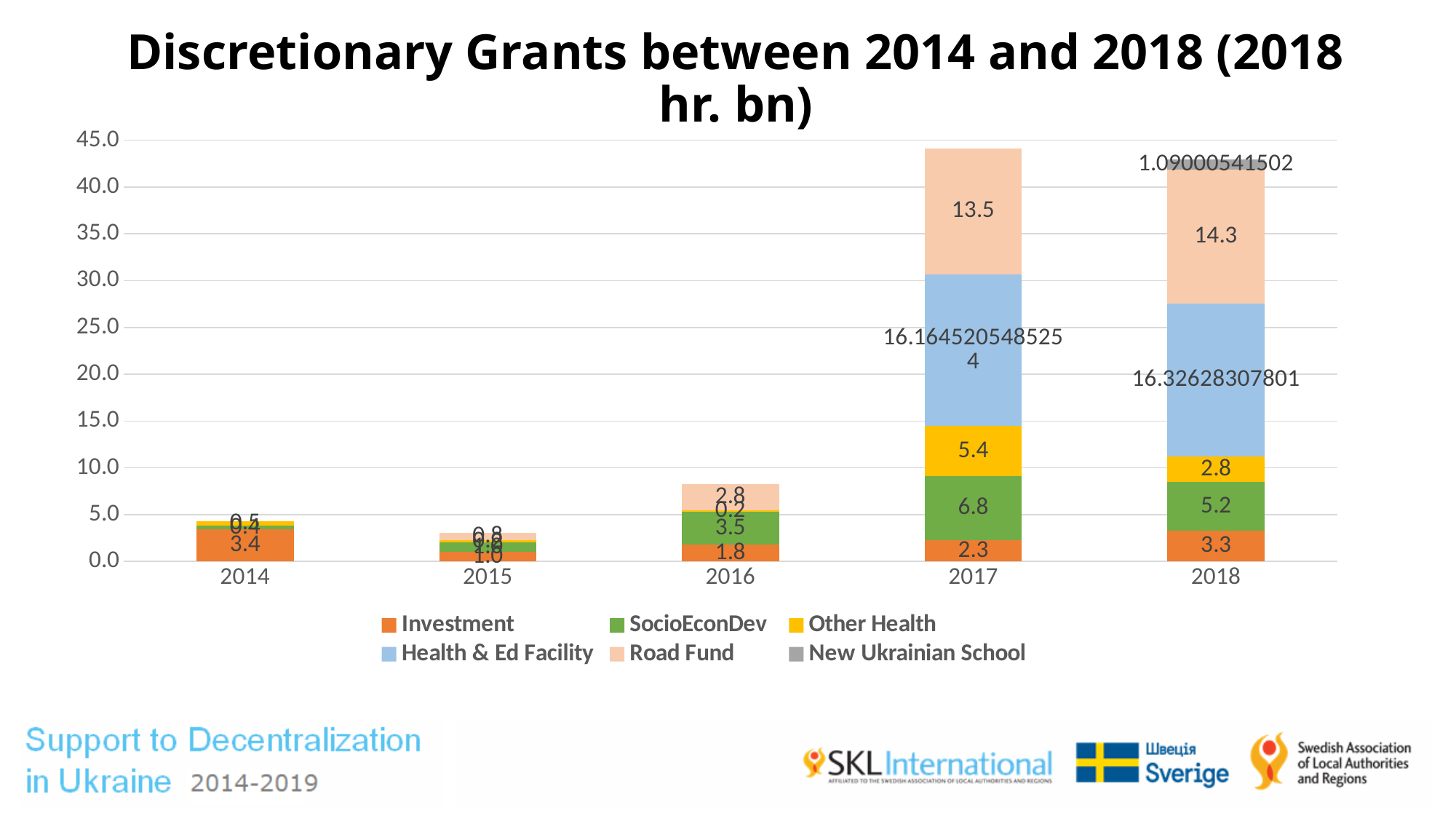
What is the Investment value for 2016? 1.8 What is the Investment value for 2018? 3.3 Which year has a larger Road Fund value, 2017 or 2018? 2018 What kind of chart is shown on the slide? Stacked bar chart What is the SocioEconDev value for 2017? 6.8 Which year has the tallest stacked bar overall? 2017 How many series does the legend list? 6 What is the Road Fund value for 2017? 13.5 How many years are shown on the x axis? 5 Is the total stacked bar for 2016 greater or less than 10.0? less What is the difference between the Other Health value in 2017 and in 2018? 2.6 Which year has the shortest stacked bar overall? 2015